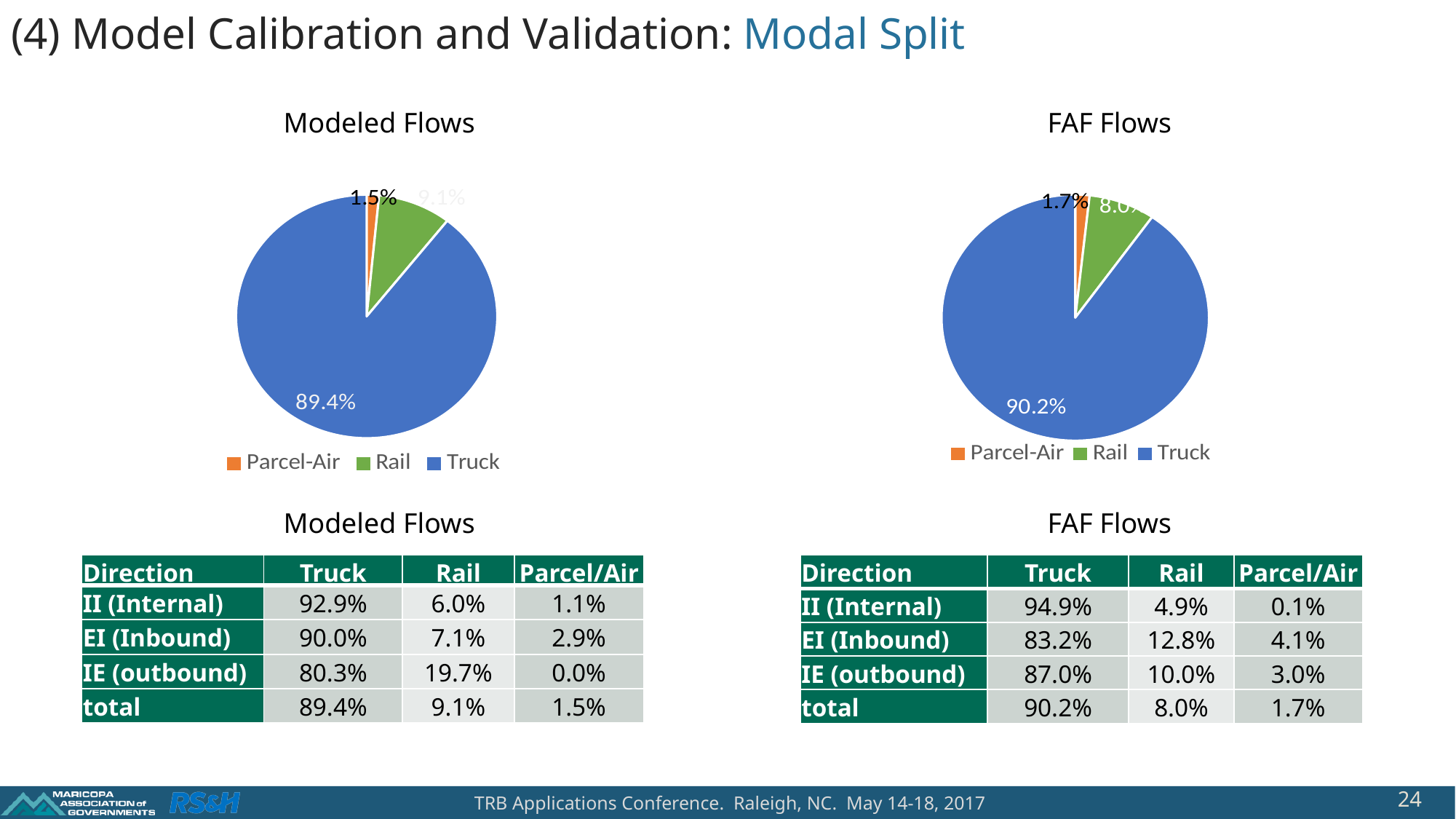
In the Modeled Flows pie chart, what is the value for Parcel-Air? 1.5% What type of chart is used for Modeled Flows? Pie chart In the Modeled Flows pie chart, what share does Truck have? 89.4% How many slices does the FAF Flows pie chart have? 3 In the Modeled Flows pie chart, which colour represents Rail? Green In the Modeled Flows pie chart, what is the value for Rail? 9.1% In the FAF Flows pie chart, what share does Truck have? 90.2% In the FAF Flows pie chart, which category has the smallest slice? Parcel-Air Which is larger: the Truck share in the Modeled Flows pie chart or the Truck share in the FAF Flows pie chart? FAF Flows In the Modeled Flows pie chart, which category has the largest slice? Truck In the Modeled Flows pie chart, what is the difference between the Rail share and the Parcel-Air share? 7.6% In the FAF Flows pie chart, what is the value for Parcel-Air? 1.7%